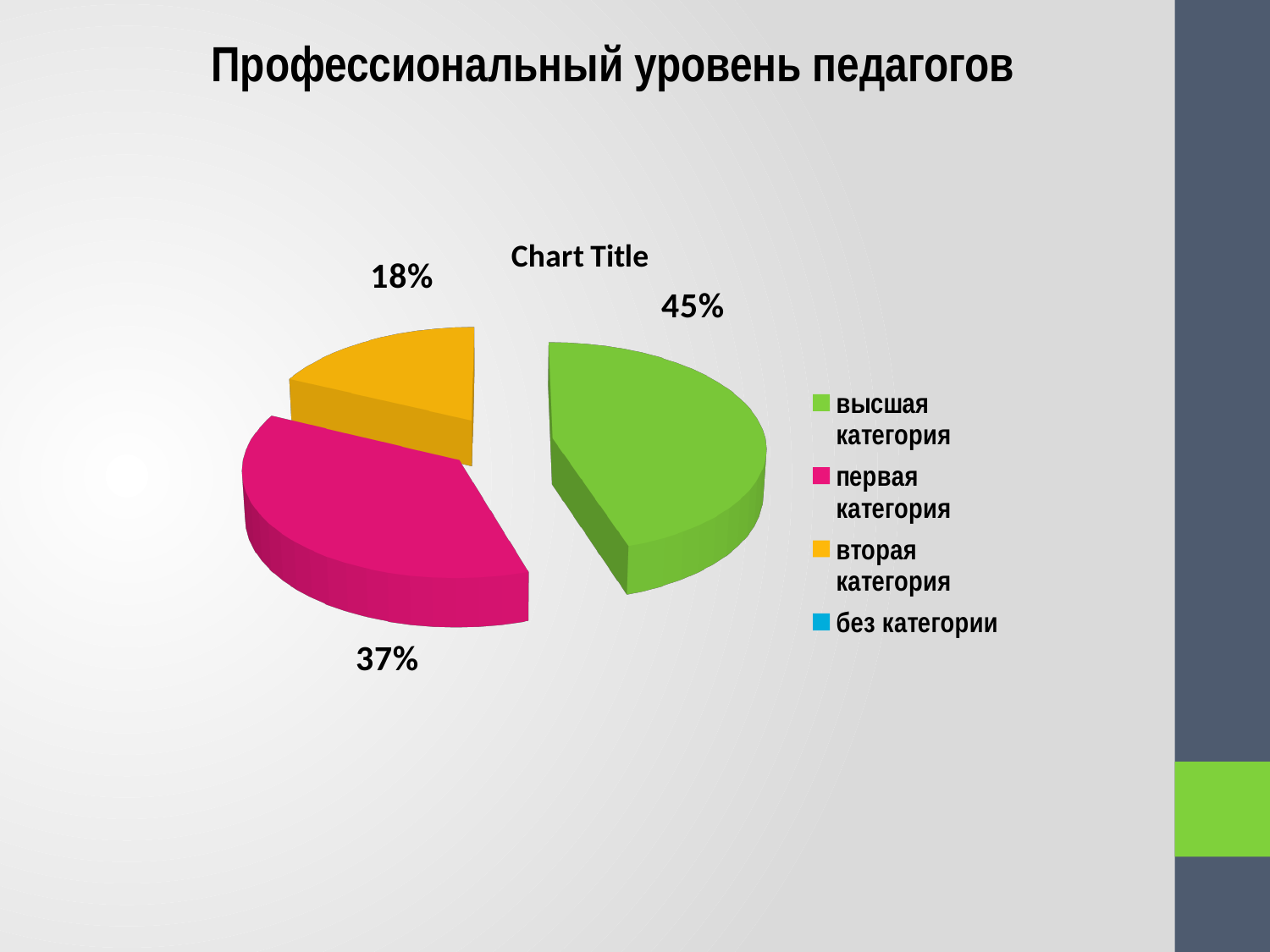
What percentage is shown for первая категория? 37% What colour is the slice for первая категория? pink Which category has the largest share of the pie? высшая категория Which is larger, the share for первая категория or the share for вторая категория? первая категория What percentage is shown for вторая категория? 18% Which of the labelled slices has the smallest share? вторая категория What is the difference in percentage points between высшая категория and первая категория? 8 What percentage of the pie is labelled for высшая категория? 45% How many slices with percentage labels are visible in the pie? 3 What is the difference in percentage points between первая категория and вторая категория? 19 How many entries does the legend list? 4 What kind of chart is shown on the slide? pie chart